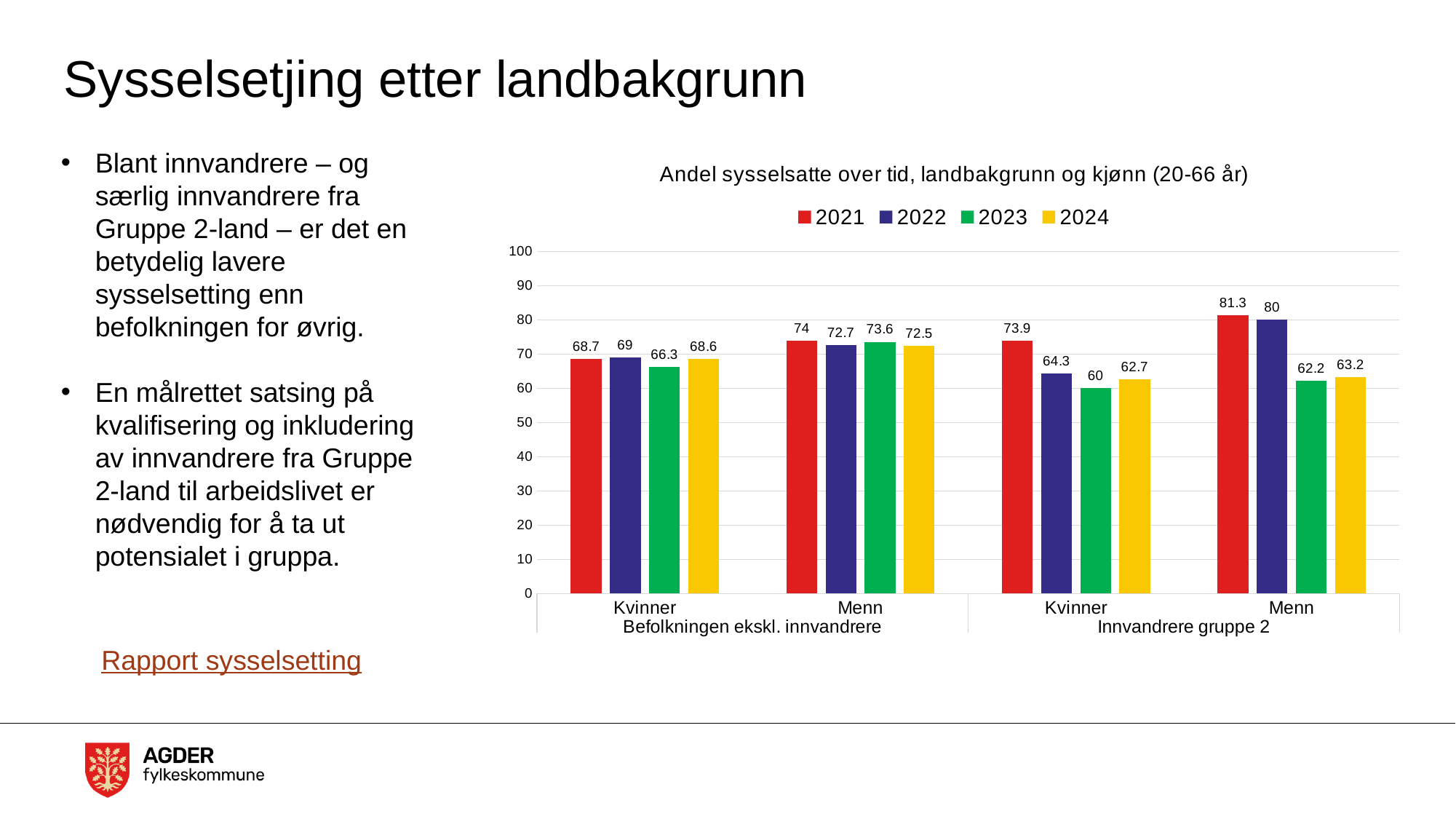
What is the difference between the 2021 and 2024 values for Menn in Innvandrere gruppe 2? 18.1 Do the values for Menn in Innvandrere gruppe 2 rise or fall from 2021 to 2023? Fall Which is larger: the 2022 value for Menn in Befolkningen ekskl. innvandrere or the 2022 value for Kvinner in Innvandrere gruppe 2? Menn in Befolkningen ekskl. innvandrere How many series does the legend list? 4 Which year has the highest value for Menn in Innvandrere gruppe 2? 2021 What kind of chart is shown on the slide? Bar chart What is the value for Menn in Innvandrere gruppe 2 for 2024? 63.2 Which year has the lowest value for Kvinner in Befolkningen ekskl. innvandrere? 2023 What is the value for Kvinner in Befolkningen ekskl. innvandrere for 2021? 68.7 Is the 2021 value for Menn in Innvandrere gruppe 2 greater or less than 80? greater What is the value for Kvinner in Innvandrere gruppe 2 for 2023? 60 What is the title of the chart? Andel sysselsatte over tid, landbakgrunn og kjønn (20-66 år)